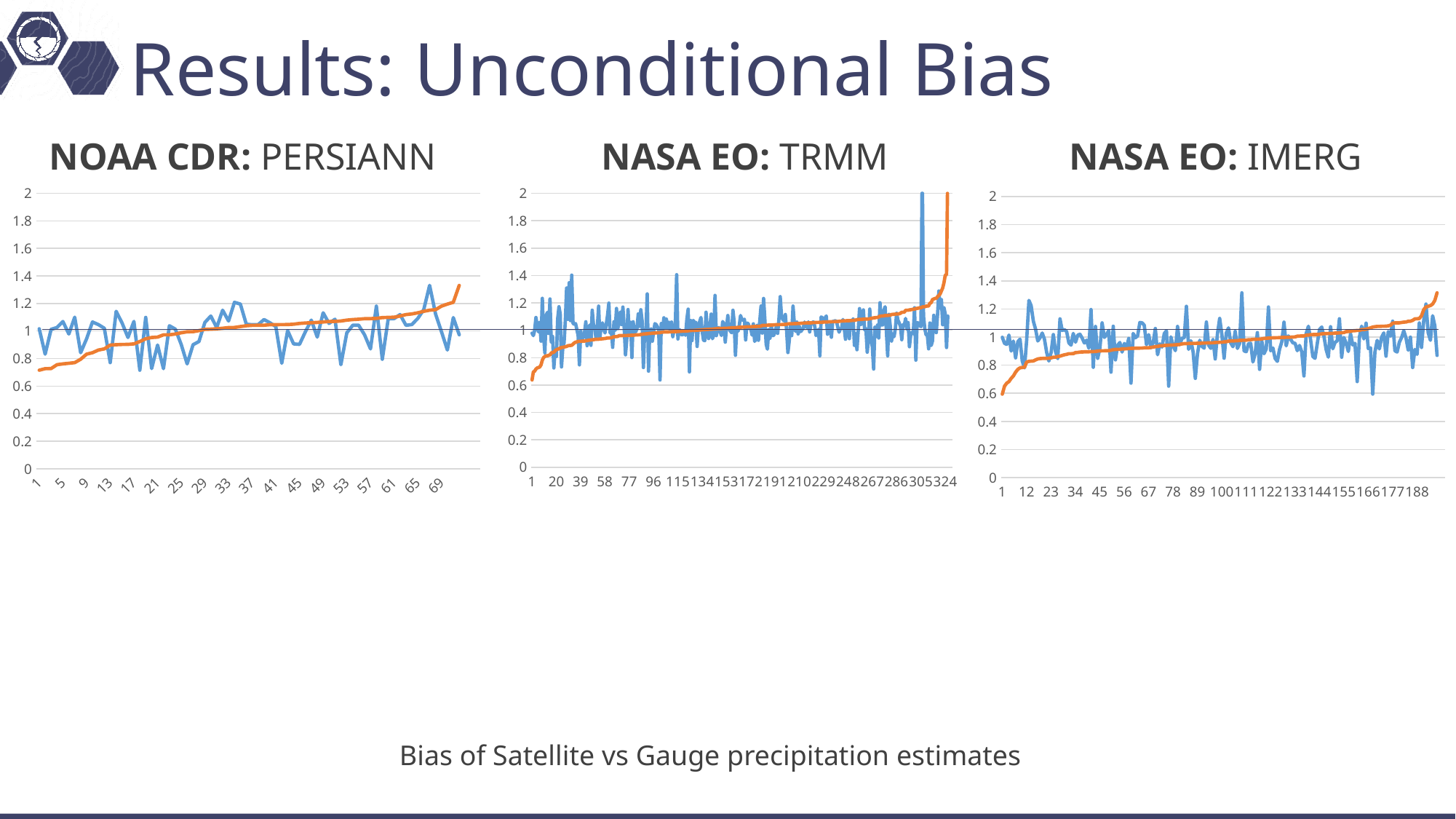
What is the maximum value shown on the y axis of the NASA EO: IMERG chart? 2 How many charts are shown on the slide? 3 In the NASA EO: TRMM chart, is the highest value reached by the orange line greater or less than 1.8? greater In the NOAA CDR: PERSIANN chart, is the value of the orange line at x = 1 greater or less than 0.8? less What kind of chart is the NOAA CDR: PERSIANN chart? line chart In the NASA EO: IMERG chart, does the orange line rise or fall along the x axis? rise In the NASA EO: IMERG chart, is the value of the orange line at x = 1 greater or less than 0.8? less In the NASA EO: TRMM chart, does the orange line rise or fall along the x axis? rise What is the caption printed below the three charts? Bias of Satellite vs Gauge precipitation estimates